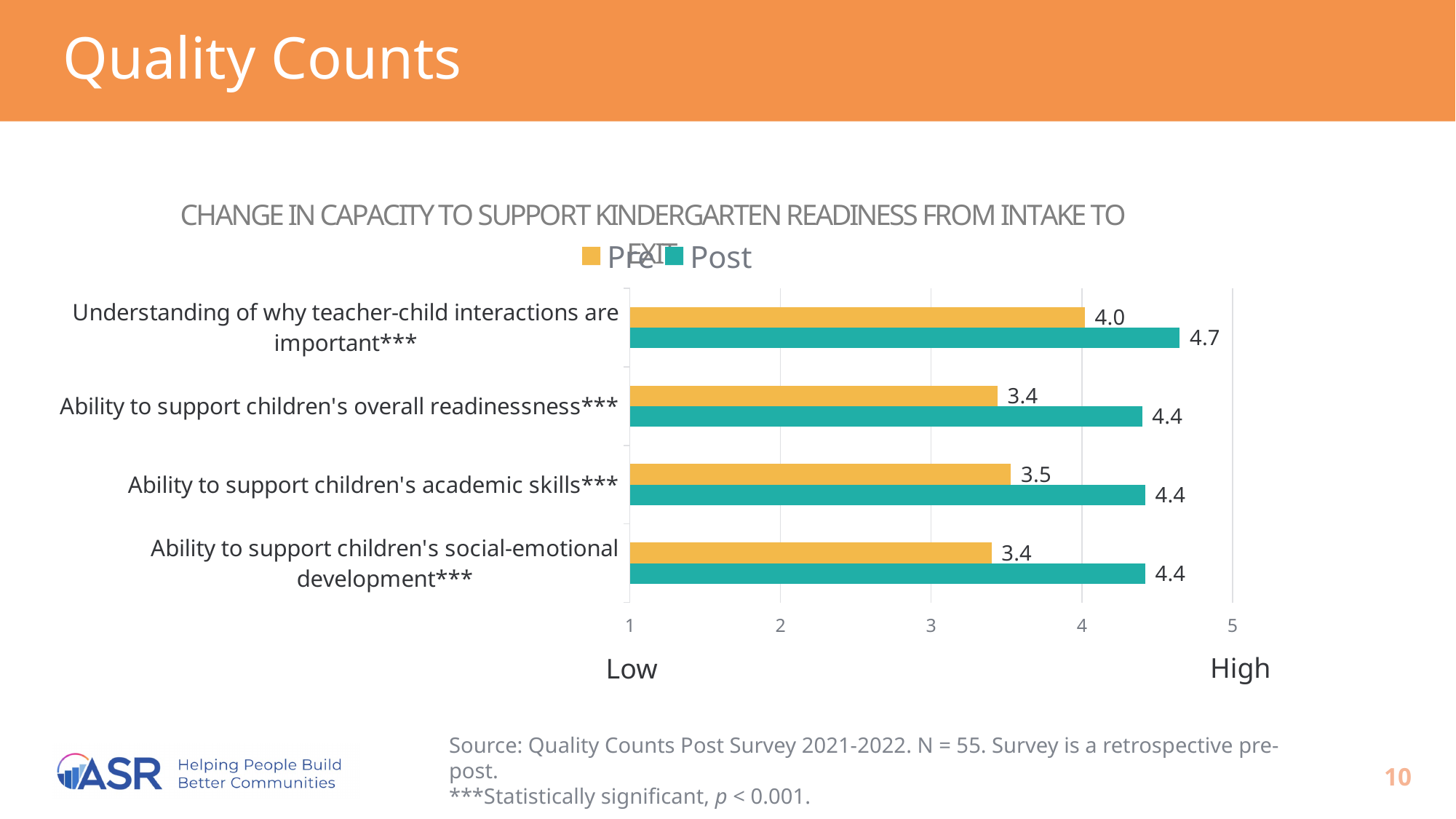
What is the Pre value for "Ability to support children's academic skills"? 3.5 What is the Post value for "Ability to support children's overall readinessness"? 4.4 What is the difference between the Post and Pre values for "Understanding of why teacher-child interactions are important"? 0.7 What is the Post value for "Understanding of why teacher-child interactions are important"? 4.7 What is the Pre value for "Ability to support children's social-emotional development"? 3.4 Which category has the highest Post value? Understanding of why teacher-child interactions are important What kind of chart is shown on the slide? Bar chart How many categories are shown on the chart? 4 What is the difference between the Post and Pre values for "Ability to support children's overall readinessness"? 1.0 How many series does the legend list? 2 Which is larger: the Pre value for "Ability to support children's academic skills" or the Pre value for "Ability to support children's social-emotional development"? Ability to support children's academic skills Which category has the highest Pre value? Understanding of why teacher-child interactions are important